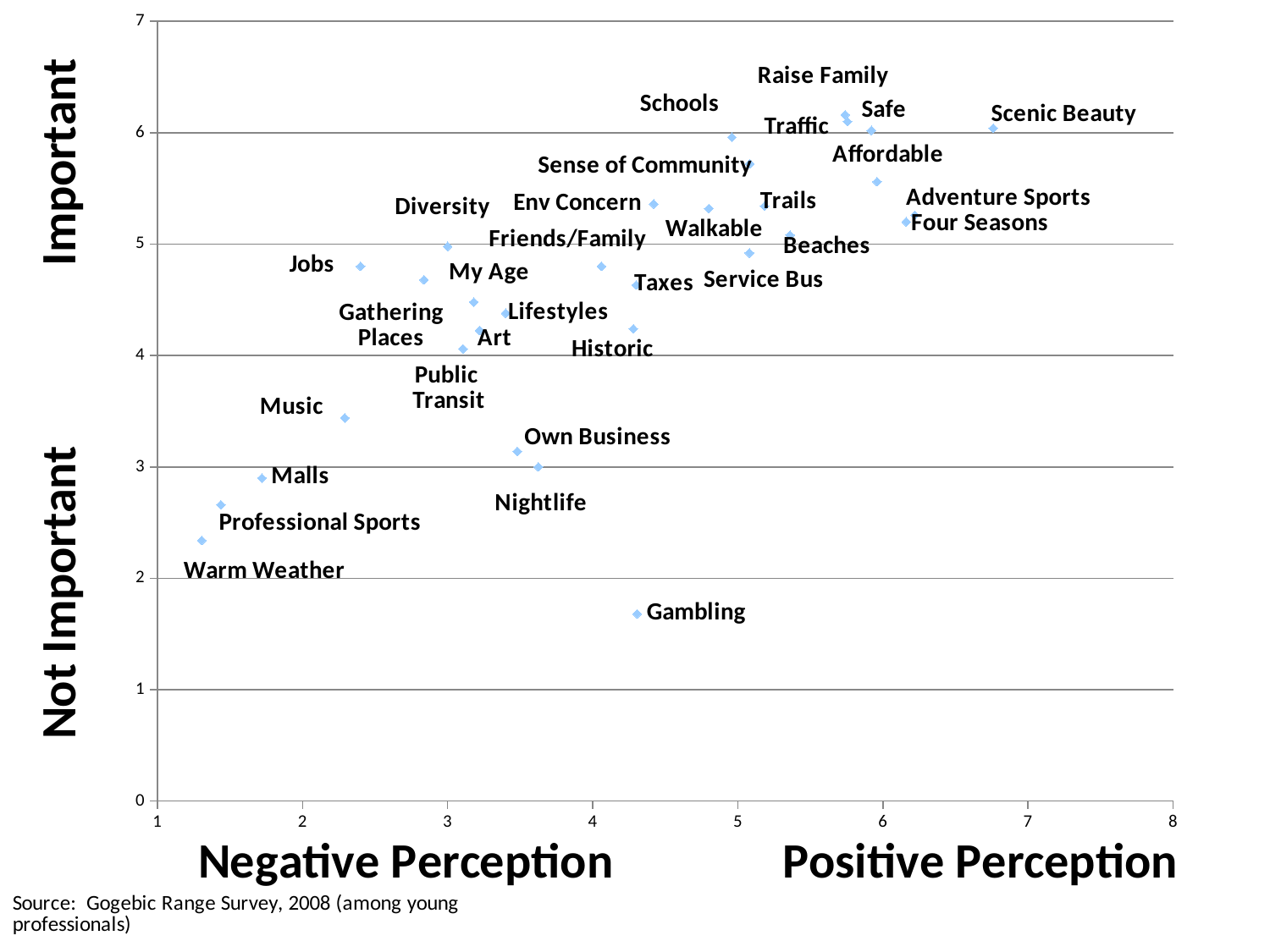
Is the perception (x-axis) value for Jobs greater or less than 3? less What is the label at the right end of the x axis? Positive Perception Which item has the lowest importance rating on the chart? Gambling Which item is plotted furthest toward Negative Perception (lowest x value)? Warm Weather Which has a higher importance value, Gambling or Nightlife? Nightlife Which has a higher importance value, Jobs or Music? Jobs Is the importance value for Affordable greater or less than 5? greater What kind of chart is shown on the slide? scatter chart Which item is plotted furthest toward Positive Perception (highest x value)? Scenic Beauty Is the importance value for Music greater or less than 4? less